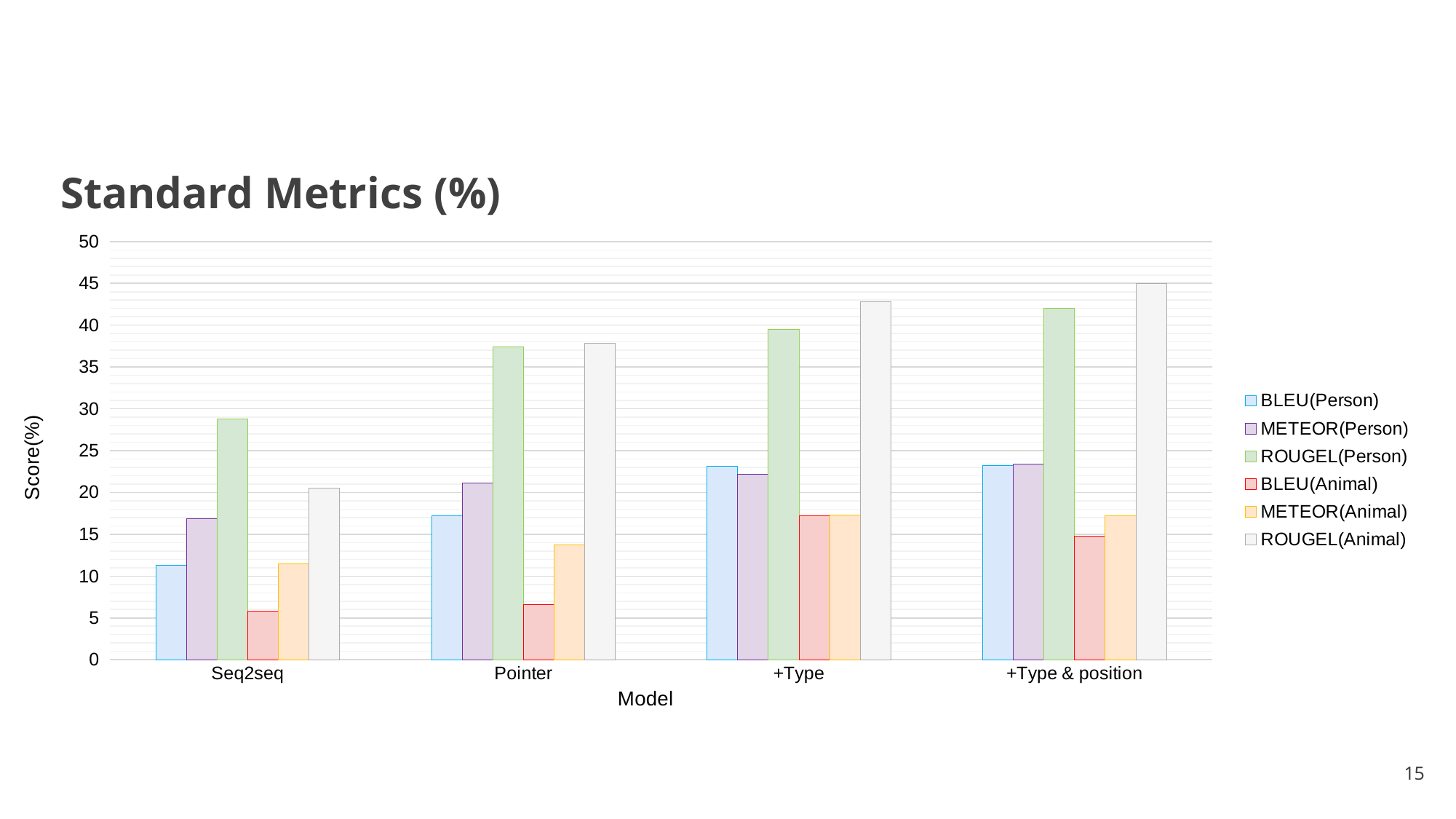
What kind of chart is shown on the slide? bar chart Does the ROUGEL(Person) score rise or fall from Seq2seq to +Type & position? rise For Seq2seq, which is larger: ROUGEL(Person) or ROUGEL(Animal)? ROUGEL(Person) Is the ROUGEL(Animal) value for +Type greater or less than 40? greater What is the label of the y axis? Score(%) Which model has the lowest BLEU(Animal) score? Seq2seq Is the ROUGEL(Person) value for Seq2seq greater or less than 25? greater Is the BLEU(Animal) value for Pointer greater or less than 10? less How many models are shown along the x axis? 4 Which model has the highest ROUGEL(Animal) score? +Type & position How many series does the legend list? 6 What is the label of the x axis? Model